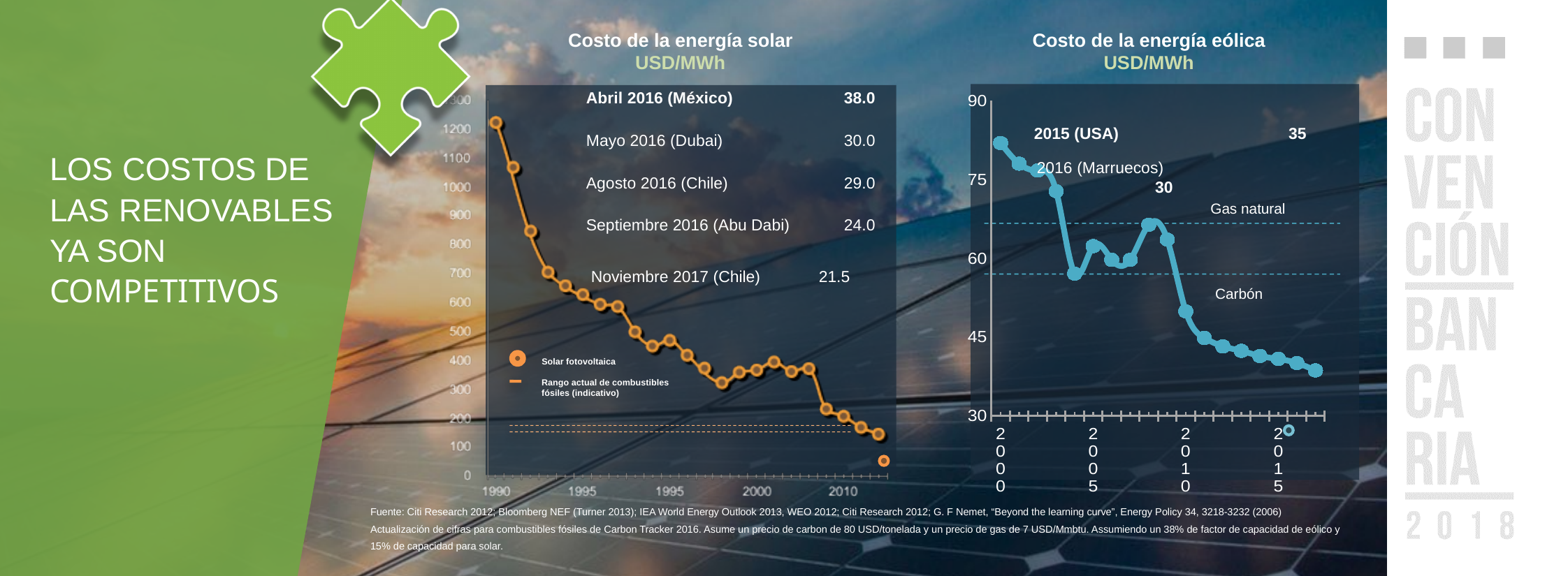
What kind of chart is the 'Costo de la energía solar' chart? line chart In the 'Costo de la energía solar' chart, what is the difference between the Abril 2016 (México) value and the Noviembre 2017 (Chile) value? 16.5 In the 'Costo de la energía solar' chart, is the value for 1990 greater or less than 1000? greater In the 'Costo de la energía solar' chart, which listed value is larger: Mayo 2016 (Dubai) or Agosto 2016 (Chile)? Mayo 2016 (Dubai) In the 'Costo de la energía solar' chart, do the plotted values rise or fall from 1990 to the end of the series? fall In the 'Costo de la energía eólica' chart, what value is listed for 2016 (Marruecos)? 30 In the 'Costo de la energía eólica' chart, what is the difference between the 2015 (USA) value and the 2016 (Marruecos) value? 5 In the 'Costo de la energía solar' chart, what value is listed for Abril 2016 (México)? 38.0 In the 'Costo de la energía eólica' chart, is the value for 2000 greater or less than 75? greater In the 'Costo de la energía eólica' chart, what value is listed for 2015 (USA)? 35 In the 'Costo de la energía solar' chart, what value is listed for Noviembre 2017 (Chile)? 21.5 In the 'Costo de la energía eólica' chart, do the plotted values rise or fall overall from 2000 to the end of the series? fall